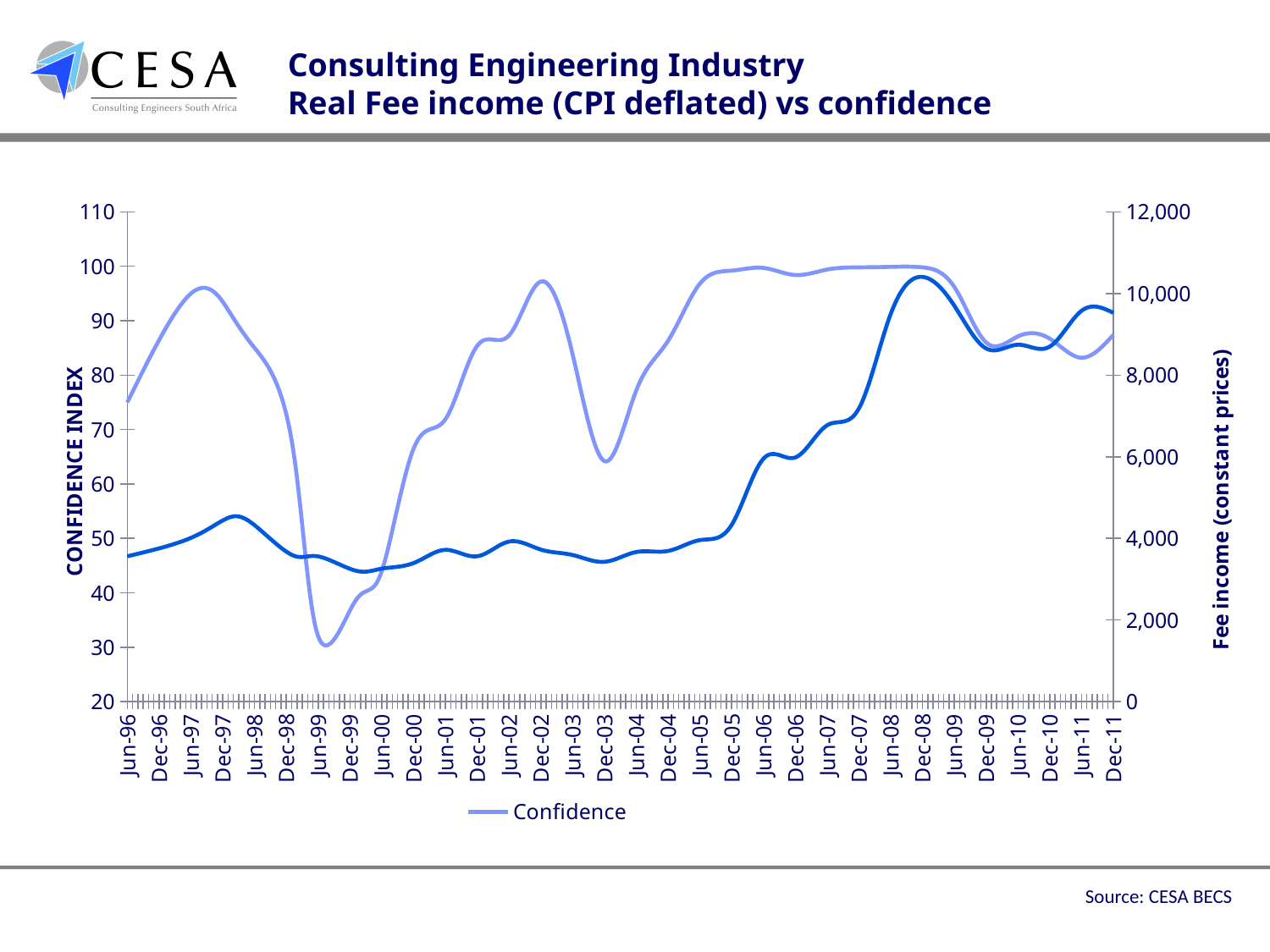
Is the Confidence value at Dec-05 greater or less than 90? greater Is the Confidence value at Dec-03 greater or less than 70? less What is the title of the left vertical axis? CONFIDENCE INDEX Is the Confidence value at Jun-99 greater or less than 40? less Does the Confidence line rise or fall between Jun-97 and Jun-99? fall What is the title of the right vertical axis? Fee income (constant prices) How many series does the chart's legend list? 1 What kind of chart is shown on the slide? Line chart Does the Fee income line rise or fall between Dec-05 and Dec-08? rise